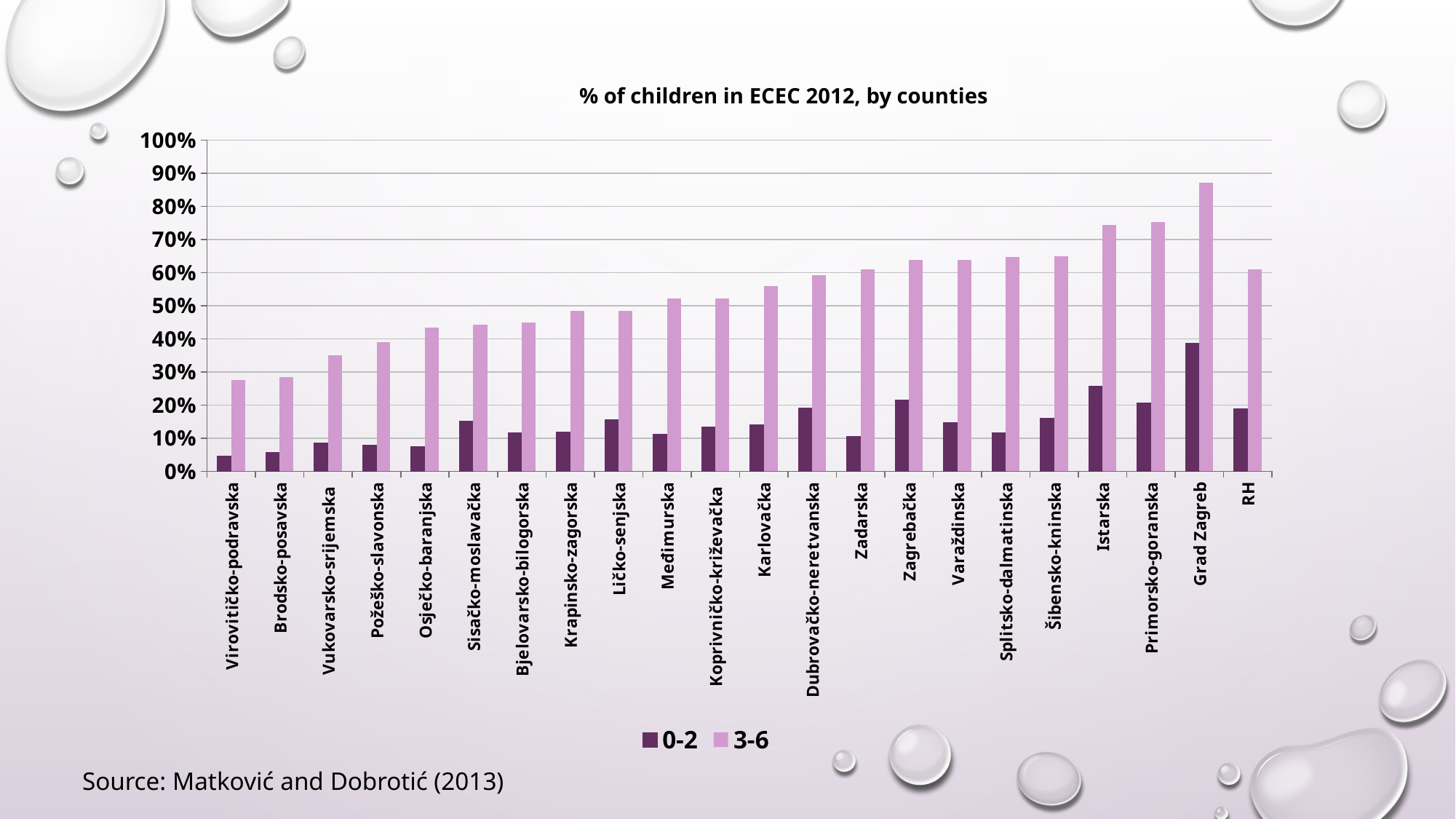
How many categories are shown on the x axis? 22 What kind of chart is shown on the slide? bar chart Is the 3-6 value for Grad Zagreb greater or less than 80%? greater What is the title of the chart? % of children in ECEC 2012, by counties Which category has the highest value for the 3-6 series? Grad Zagreb Is the 3-6 value for Virovitičko-podravska greater or less than 30%? less Which category has the lowest value for the 3-6 series? Virovitičko-podravska Which category has the highest value for the 0-2 series? Grad Zagreb Is the 0-2 value for Grad Zagreb greater or less than 30%? greater Which is larger, the 0-2 value for Grad Zagreb or the 0-2 value for Istarska? Grad Zagreb Do the 3-6 values generally rise or fall from Virovitičko-podravska to Grad Zagreb along the x axis? rise How many series does the legend list? 2